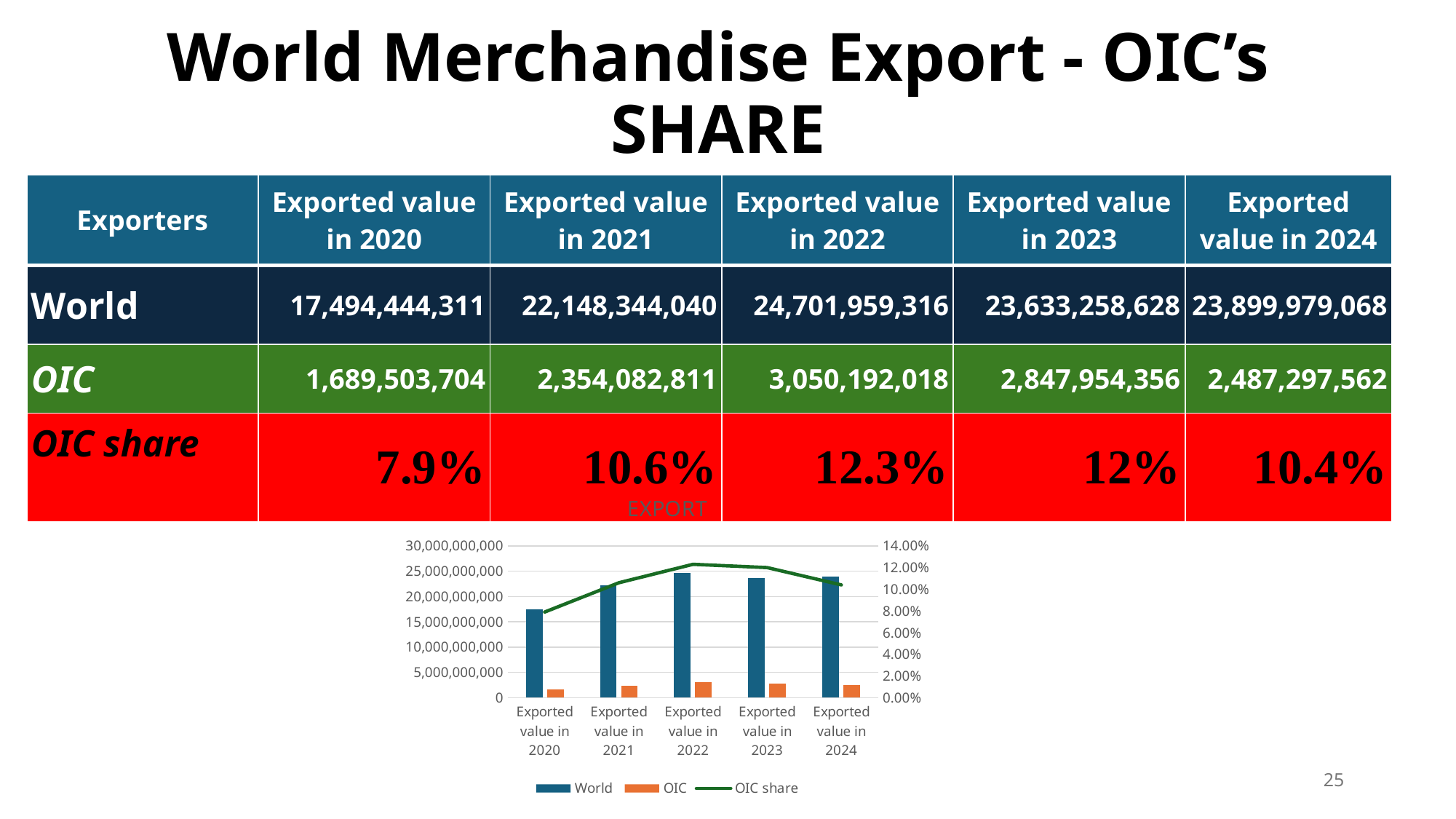
Which series is drawn as a green line in the chart? OIC share What is the OIC share in 2022? 12.3% How many series does the chart legend list? 3 How many categories (years) are plotted on the x axis of the chart? 5 What type of chart is shown on the slide? Combination bar and line chart What is the title of the chart? EXPORT How does the OIC share line move from 2020 to 2024? Rises until 2022, then falls In which year is the OIC share lowest? 2020 In which year is the World exported value highest? 2022 Which is larger, the OIC exported value in 2022 or in 2024? 2022 Is the World exported value in 2020 greater or less than 20,000,000,000? less What is the World exported value in 2021? 22,148,344,040